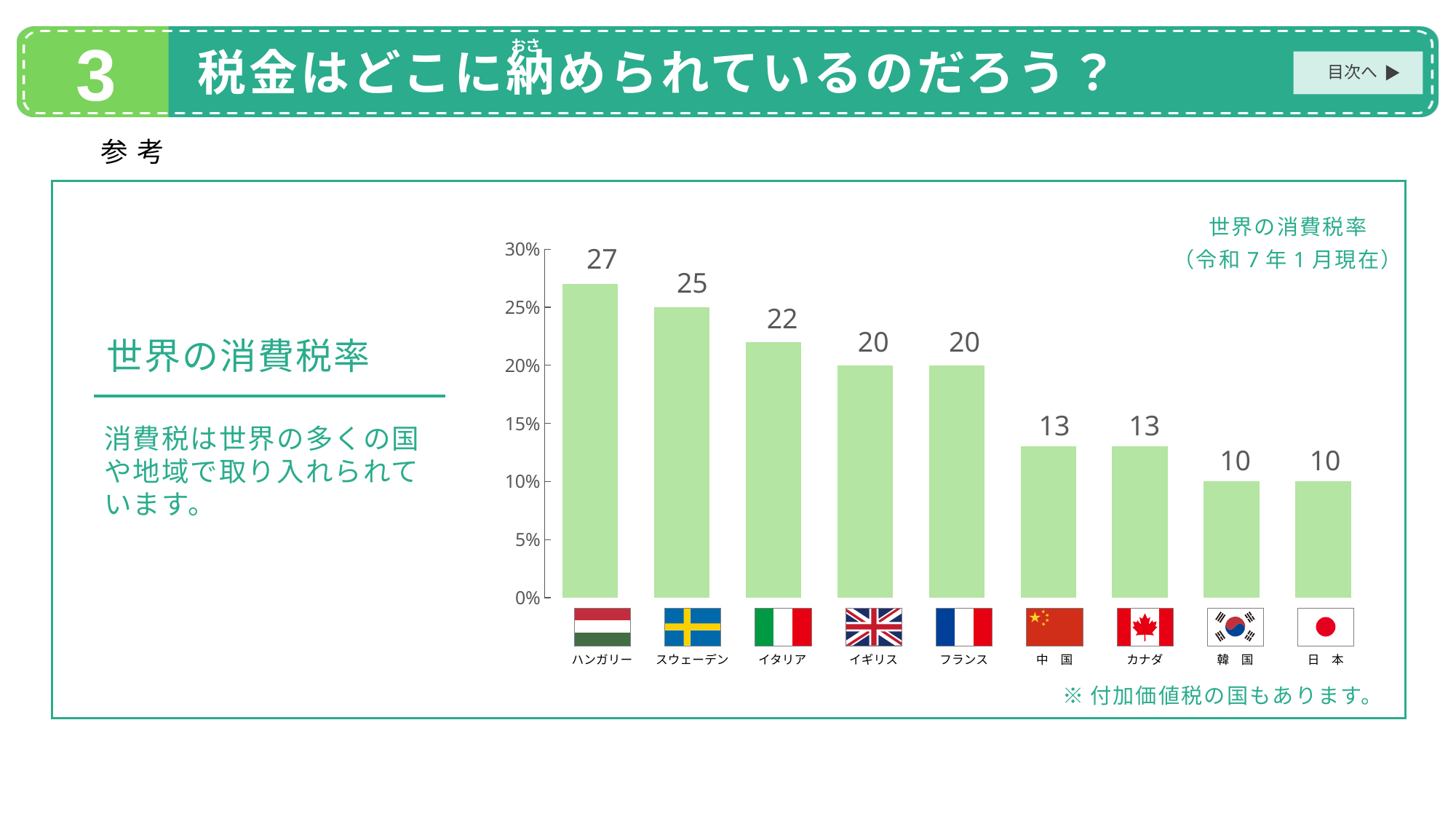
What is the title of the chart shown in the top right of the chart area? 世界の消費税率（令和7年1月現在） How many countries are shown in the chart? 9 What is the difference between the values for ハンガリー (Hungary) and 日本 (Japan)? 17 Which is larger, the value for イタリア (Italy) or the value for フランス (France)? イタリア Do the values rise or fall from left to right across the chart? fall What kind of chart is shown on the slide? bar chart What value is shown for イタリア (Italy)? 22 Is the value for 中国 (China) greater or less than 15%? less What is the difference between the values for スウェーデン (Sweden) and イギリス (UK)? 5 Which country has the highest consumption tax rate in the chart? ハンガリー What is the consumption tax rate shown for ハンガリー (Hungary)? 27 What value is shown for 日本 (Japan) in the chart? 10